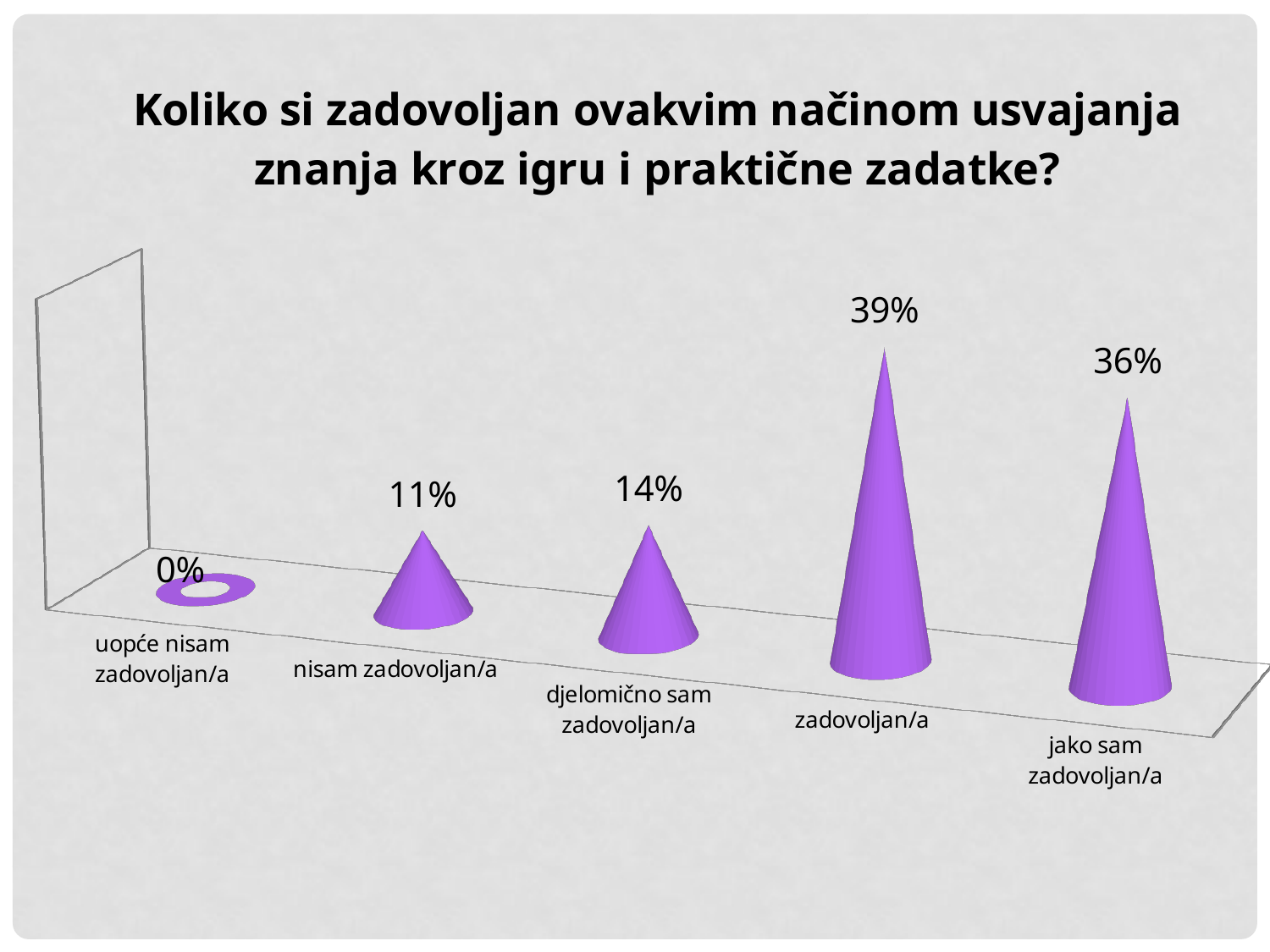
How many categories are shown in the chart? 5 What is the value for "uopće nisam zadovoljan/a"? 0% Which category has the highest value? zadovoljan/a What is the difference between the values for "djelomično sam zadovoljan/a" and "nisam zadovoljan/a"? 3% What is the value for "zadovoljan/a"? 39% What is the value for "jako sam zadovoljan/a"? 36% What is the value for "djelomično sam zadovoljan/a"? 14% What is the difference between the values for "zadovoljan/a" and "jako sam zadovoljan/a"? 3% Which is larger, the value for "nisam zadovoljan/a" or the value for "djelomično sam zadovoljan/a"? djelomično sam zadovoljan/a Which category has the lowest value? uopće nisam zadovoljan/a What is the title of the chart? Koliko si zadovoljan ovakvim načinom usvajanja znanja kroz igru i praktične zadatke? What is the value for "nisam zadovoljan/a"? 11%